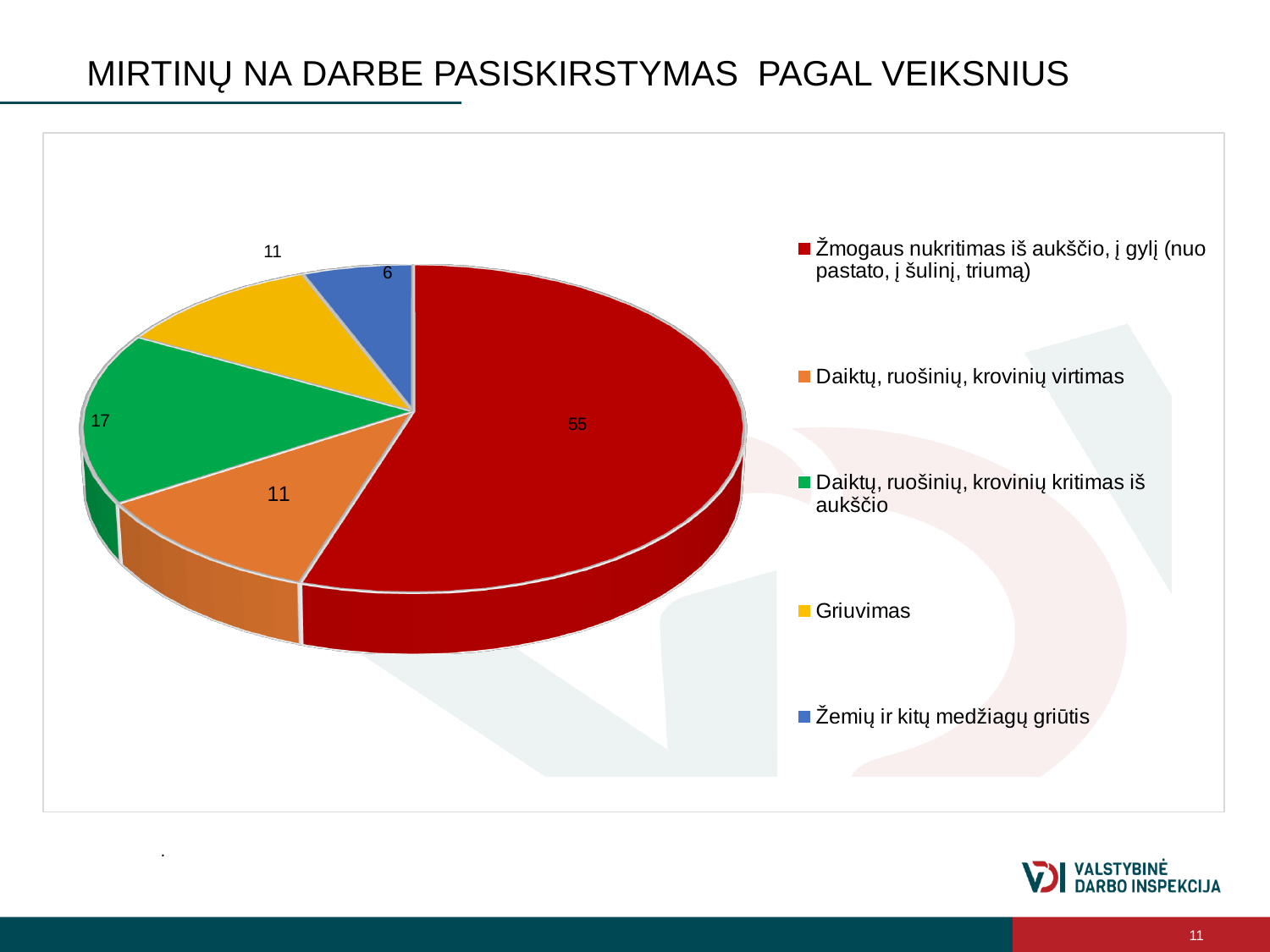
Which category has the largest slice of the pie? Žmogaus nukritimas iš aukščio, į gylį (nuo pastato, į šulinį, triumą) What type of chart is shown on the slide? Pie chart What is the difference between the values for "Žmogaus nukritimas iš aukščio, į gylį (nuo pastato, į šulinį, triumą)" and "Daiktų, ruošinių, krovinių kritimas iš aukščio"? 38 What share of the pie does "Žmogaus nukritimas iš aukščio, į gylį (nuo pastato, į šulinį, triumą)" represent? 55% How many categories does the pie chart have? 5 What colour is the slice for "Griuvimas"? Yellow What is the value for "Griuvimas"? 11 Which is larger: the value for "Daiktų, ruošinių, krovinių kritimas iš aukščio" or the value for "Daiktų, ruošinių, krovinių virtimas"? Daiktų, ruošinių, krovinių kritimas iš aukščio What is the value for "Žemių ir kitų medžiagų griūtis"? 6 What is the value for "Žmogaus nukritimas iš aukščio, į gylį (nuo pastato, į šulinį, triumą)"? 55 Which category has the smallest slice of the pie? Žemių ir kitų medžiagų griūtis What is the value for "Daiktų, ruošinių, krovinių kritimas iš aukščio"? 17